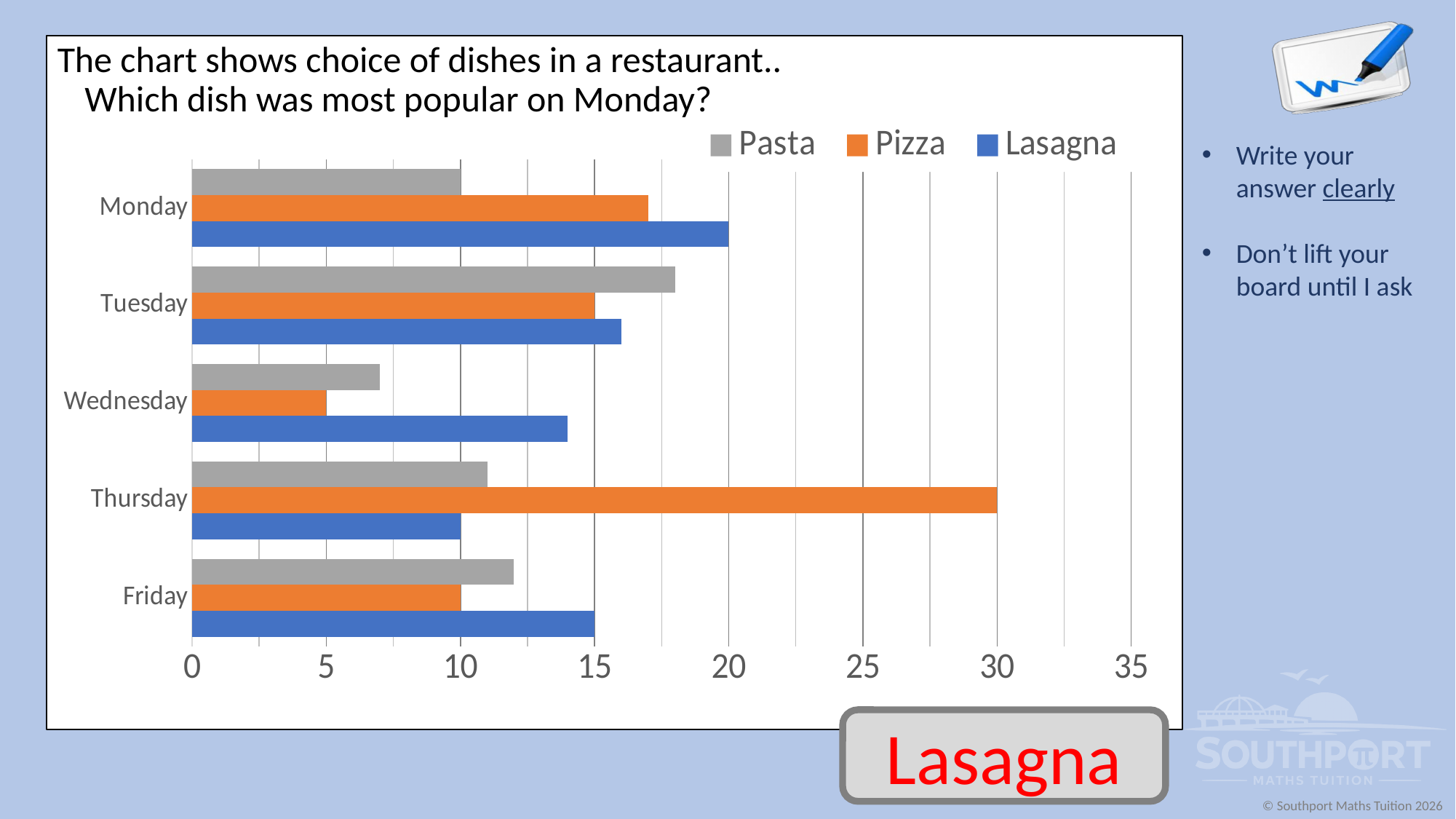
What is the value for Lasagna on Friday? 15 On which day is the Pizza value highest? Thursday Which is larger on Wednesday, Pasta or Lasagna? Lasagna What is the value for Pizza on Wednesday? 5 How many days are shown on the chart? 5 What kind of chart is shown on the slide? bar chart What is the value for Lasagna on Monday? 20 Which dish has the highest value on Monday? Lasagna Is the value for Pasta on Tuesday greater or less than 15? greater What is the value for Pizza on Thursday? 30 How many series does the legend list? 3 On which day is the Pizza value lowest? Wednesday